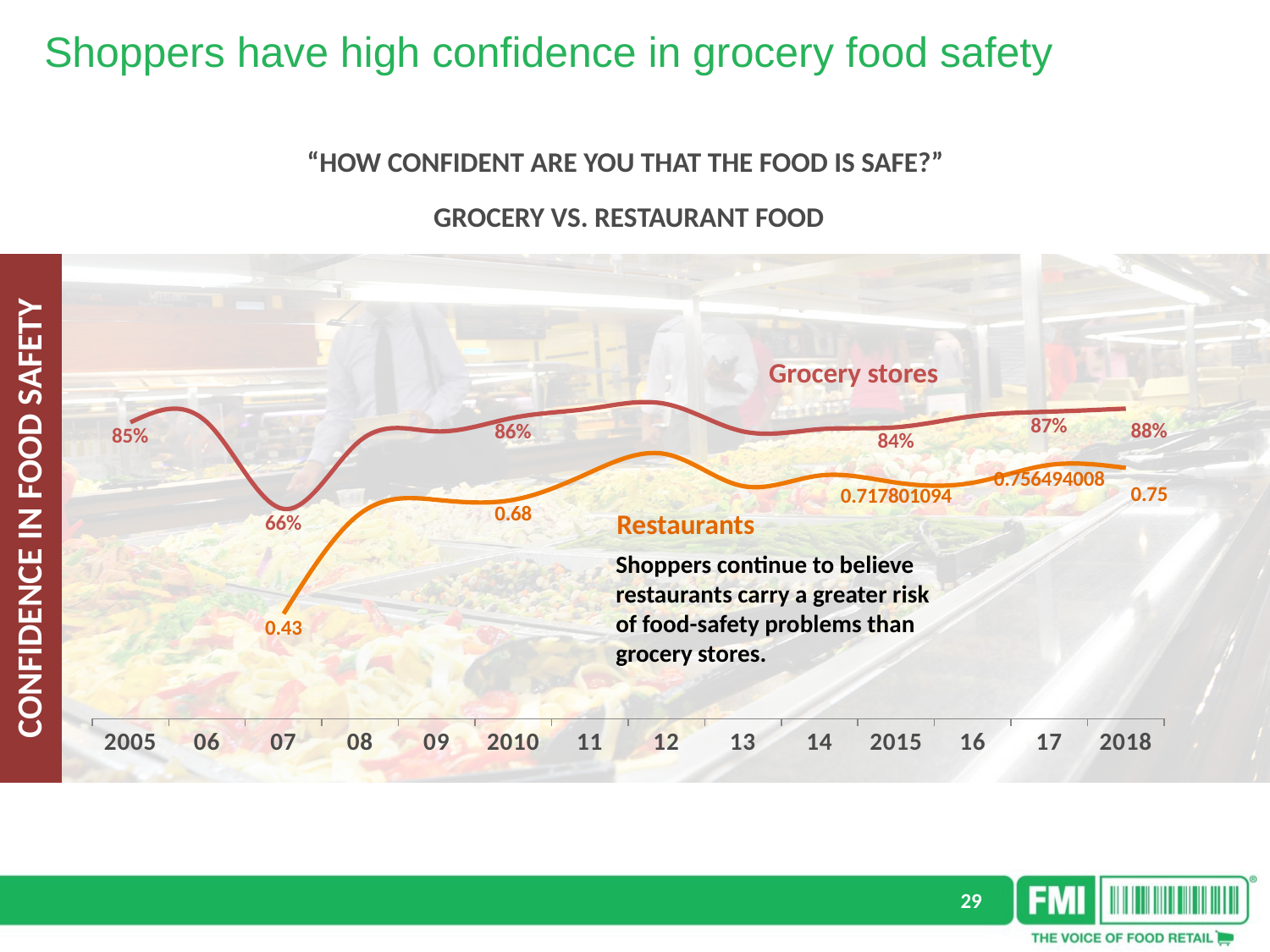
What is the Grocery stores value for 2005? 85% What is the Grocery stores value for 2018? 88% What is the Restaurants value for 2018? 0.75 What kind of chart is shown on the slide? line chart In which labelled year is the Grocery stores value lowest? 2007 What is the Grocery stores value for 2007? 66% How many series are plotted on the chart? 2 What is the Restaurants value for 2010? 0.68 What is the difference between the Grocery stores values for 2018 and 2007? 22% In which labelled year is the Grocery stores value highest? 2018 What is the Restaurants value for 2007? 0.43 Which series has the higher value in 2010, Grocery stores or Restaurants? Grocery stores